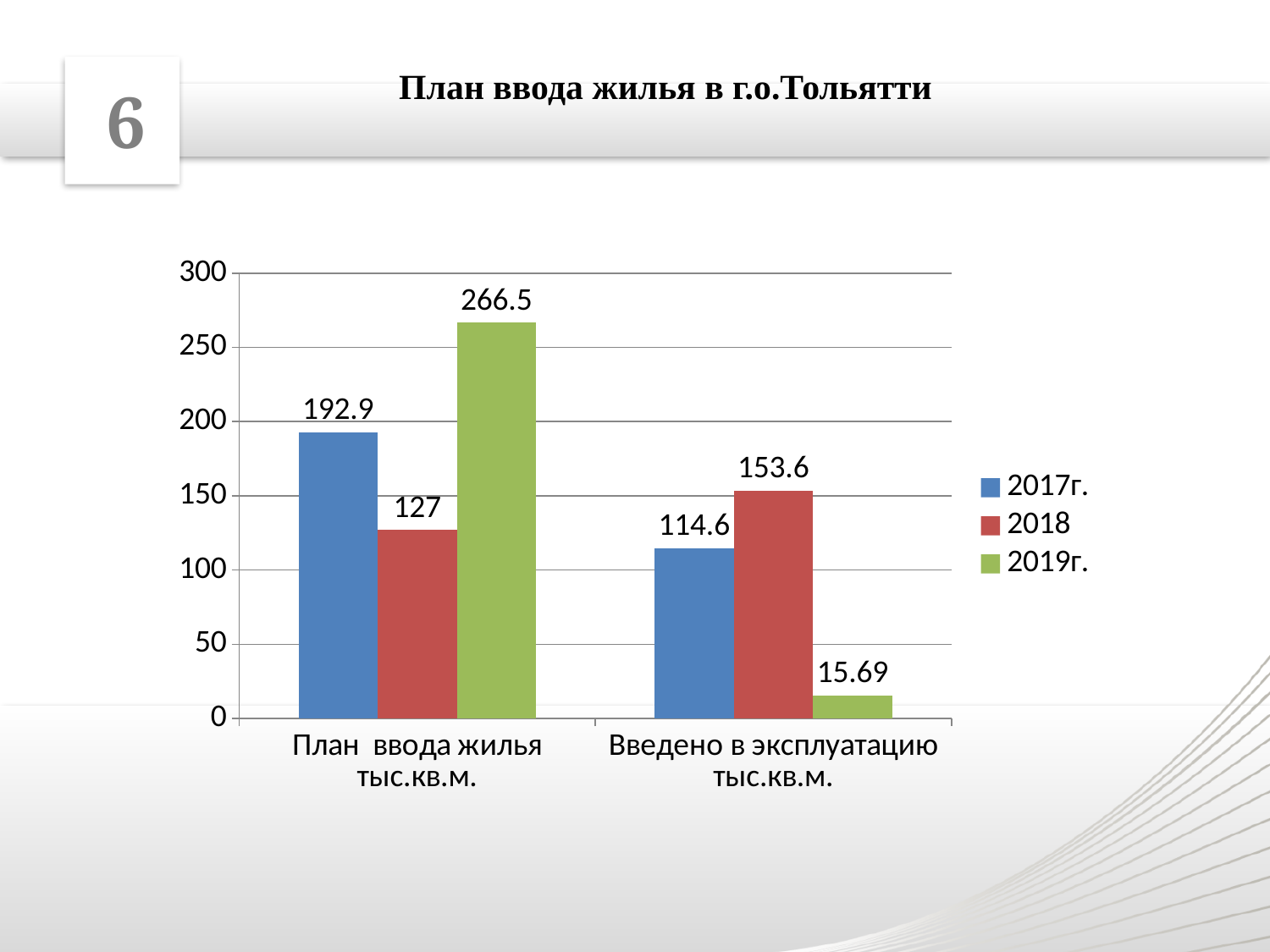
What is the value for 2018 in the category "Введено в эксплуатацию тыс.кв.м."? 153.6 Which is larger: the 2018 value for "План ввода жилья тыс.кв.м." or the 2018 value for "Введено в эксплуатацию тыс.кв.м."? Введено в эксплуатацию тыс.кв.м. What is the title of the chart on the slide? План ввода жилья в г.о.Тольятти What type of chart is shown on the slide? bar chart How many categories are shown on the x axis? 2 Which year has the highest value in the category "План ввода жилья тыс.кв.м."? 2019г. What is the value for 2017г. in the category "План ввода жилья тыс.кв.м."? 192.9 What is the difference between the 2019г. and 2017г. values in the category "План ввода жилья тыс.кв.м."? 73.6 What is the value for 2019г. in the category "План ввода жилья тыс.кв.м."? 266.5 Which year has the lowest value in the category "Введено в эксплуатацию тыс.кв.м."? 2019г. What is the value for 2019г. in the category "Введено в эксплуатацию тыс.кв.м."? 15.69 How many series does the legend list? 3